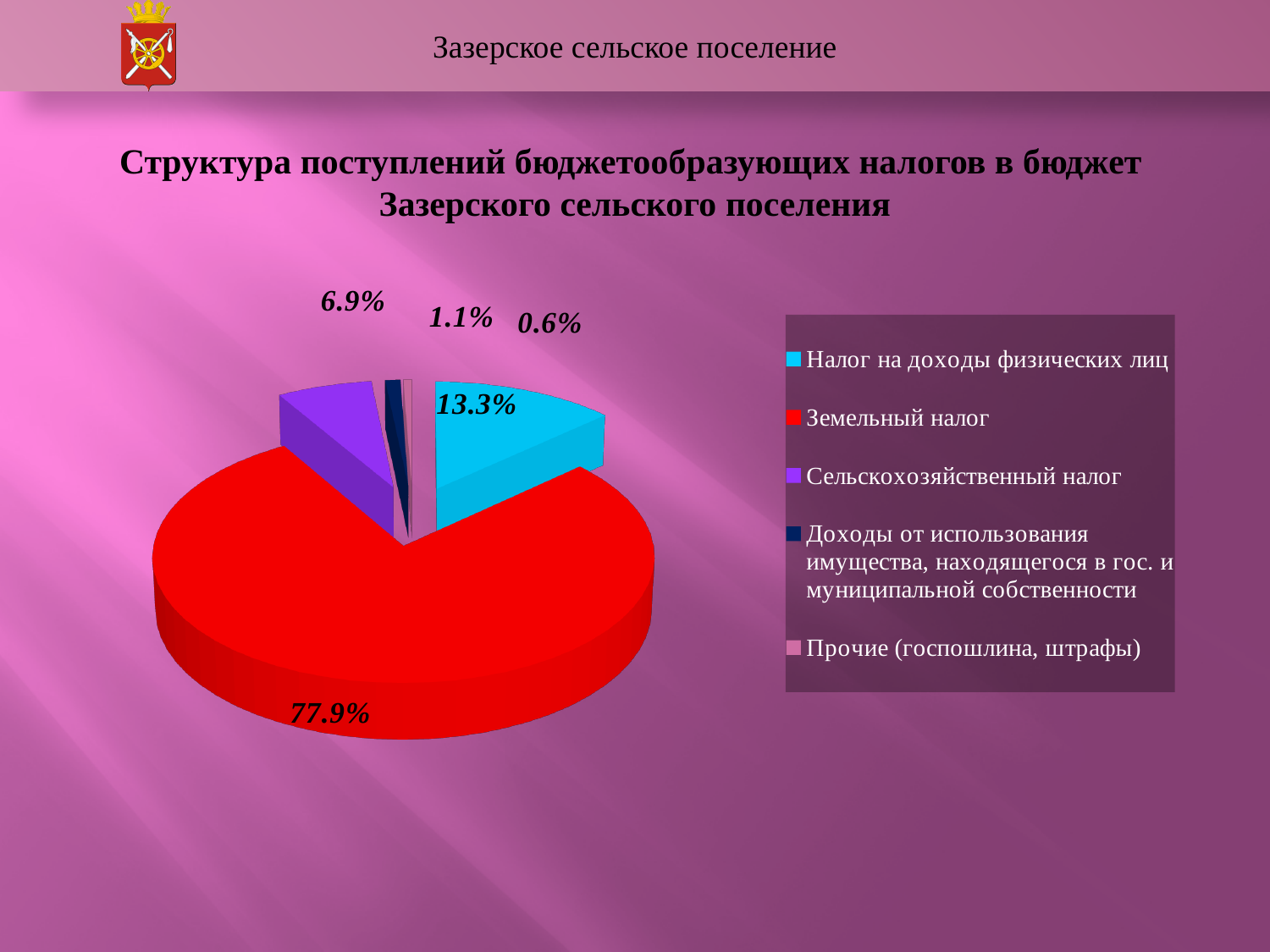
Which is larger: the share for Сельскохозяйственный налог or the share for Налог на доходы физических лиц? Налог на доходы физических лиц What share of the pie does Сельскохозяйственный налог have? 6.9% What kind of chart is shown on the slide? Pie chart What share of the pie does Налог на доходы физических лиц have? 13.3% What is the difference in percentage points between Земельный налог and Налог на доходы физических лиц? 64.6 How many categories does the legend list? 5 Which category has the smallest share of the pie? Прочие (госпошлина, штрафы) What share of the pie does Доходы от использования имущества, находящегося в гос. и муниципальной собственности have? 1.1% What share of the pie does Земельный налог have? 77.9% What share of the pie does Прочие (госпошлина, штрафы) have? 0.6% Which category has the largest share of the pie? Земельный налог What colour is the slice for Земельный налог? Red